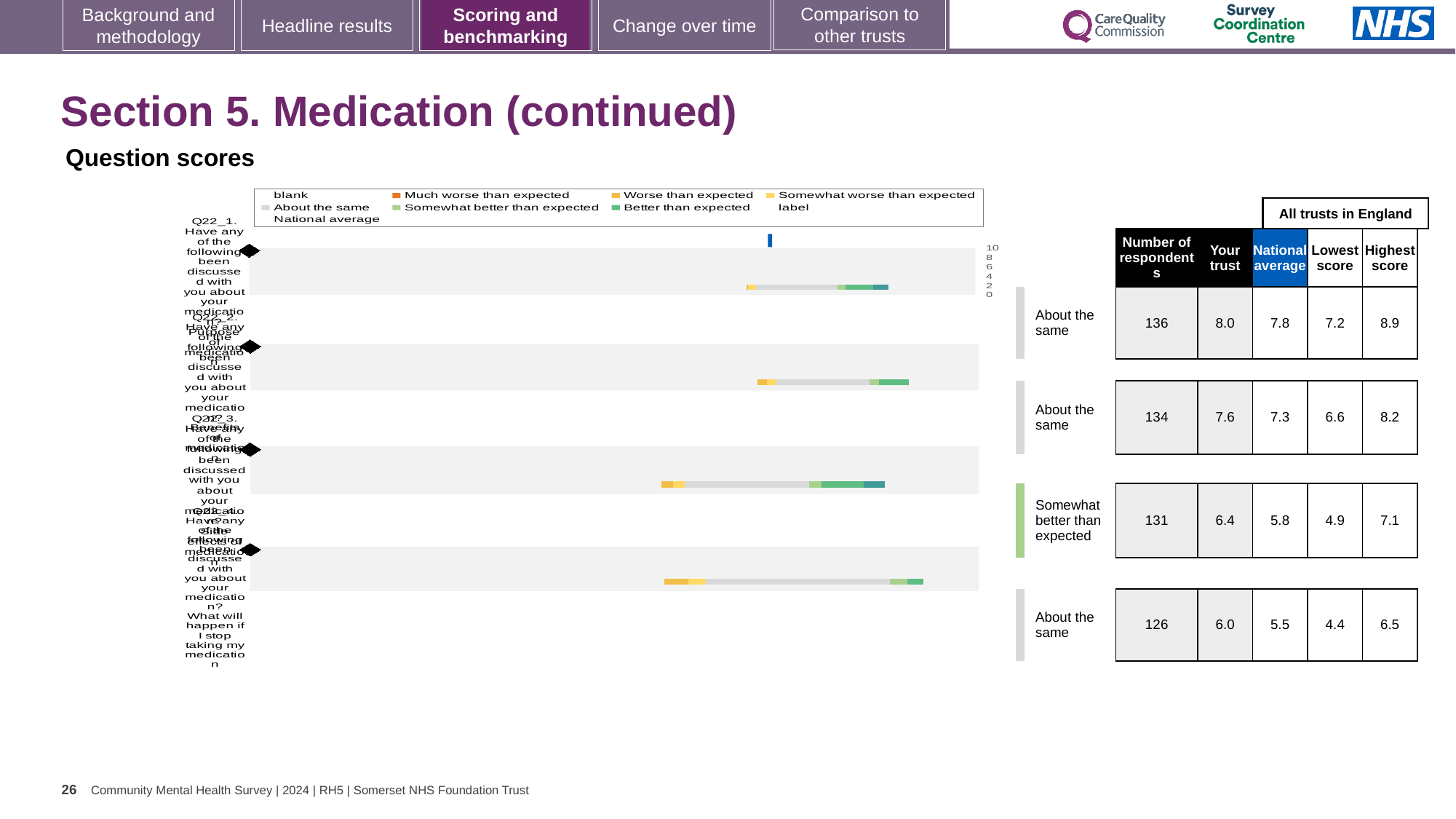
How many respondents are listed for the third row, Q22_3? 131 Which row has the lowest 'Your trust' score? Q22_4 (fourth row) For the third row, Q22_3, what is the difference between the 'Your trust' score and the national average? 0.6 What is the 'Your trust' score for the first row, Q22_1? 8.0 What is the national average for the second row, Q22_2? 7.3 Is the 'Your trust' score for the second row, Q22_2, greater or less than 7? greater What is the highest score across all trusts in England for the first row, Q22_1? 8.9 For the fourth row, Q22_4, which is larger: the 'Your trust' score or the national average? Your trust What kind of chart is shown under 'Question scores'? bar chart How many question rows (Q22_1 to Q22_4) are plotted in the chart? 4 Which row has the highest 'Your trust' score? Q22_1 (first row) What benchmark category is shown for the third row, Q22_3? Somewhat better than expected